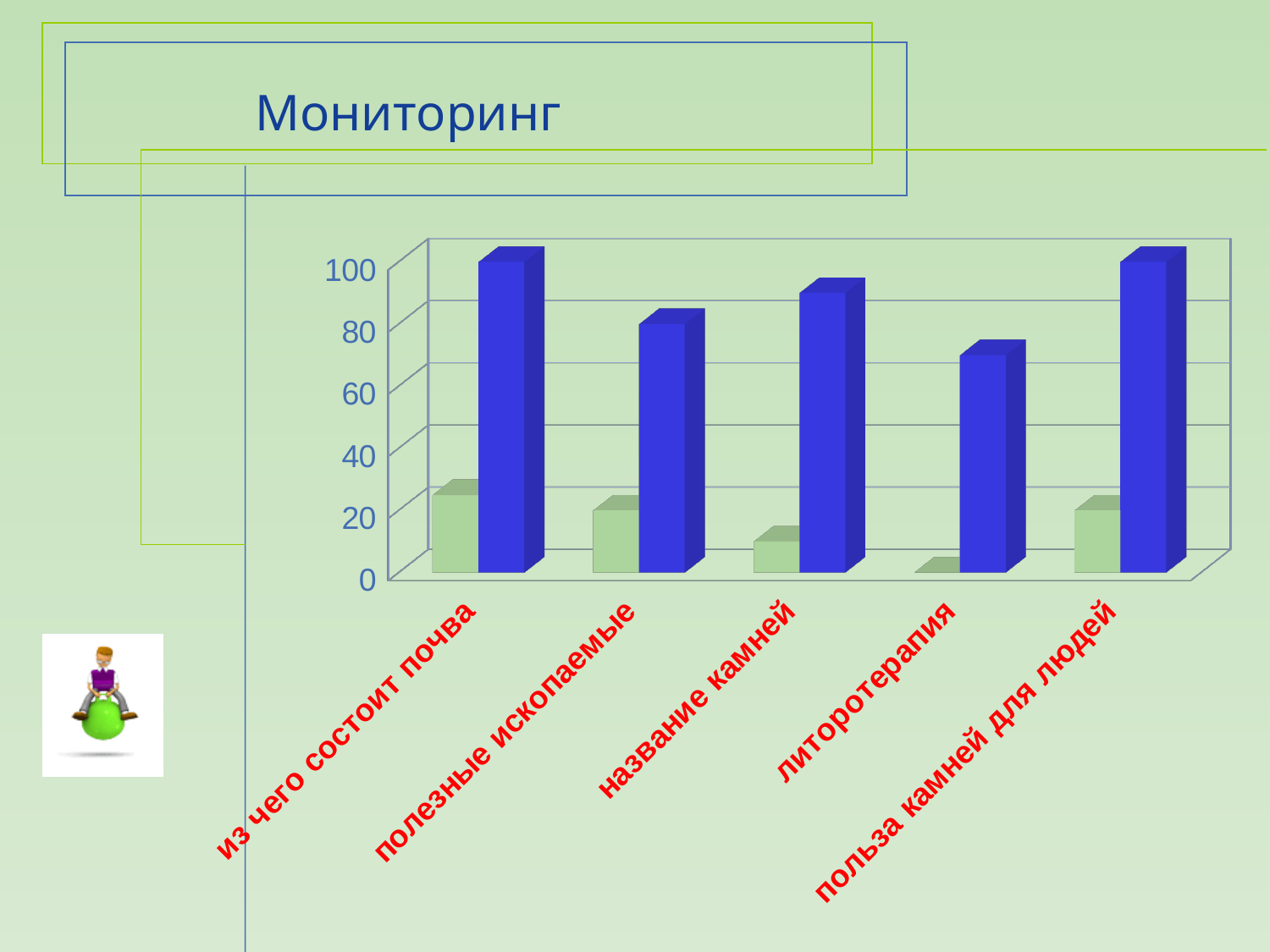
What is the title of the slide with the chart? Мониторинг Which category has the lowest light green bar? литоротерапия Which category has the lowest blue bar? литоротерапия Is the light green bar for из чего состоит почва greater or less than 40? less What kind of chart is shown on the slide? bar chart Which has the taller blue bar, название камней or полезные ископаемые? название камней Is the blue bar for литоротерапия greater or less than 80? less What two colours are used for the bars in the chart? light green and blue Is the blue bar for название камней greater or less than 80? greater How many categories are shown on the x axis of the chart? 5 Which has the taller blue bar, полезные ископаемые or литоротерапия? полезные ископаемые